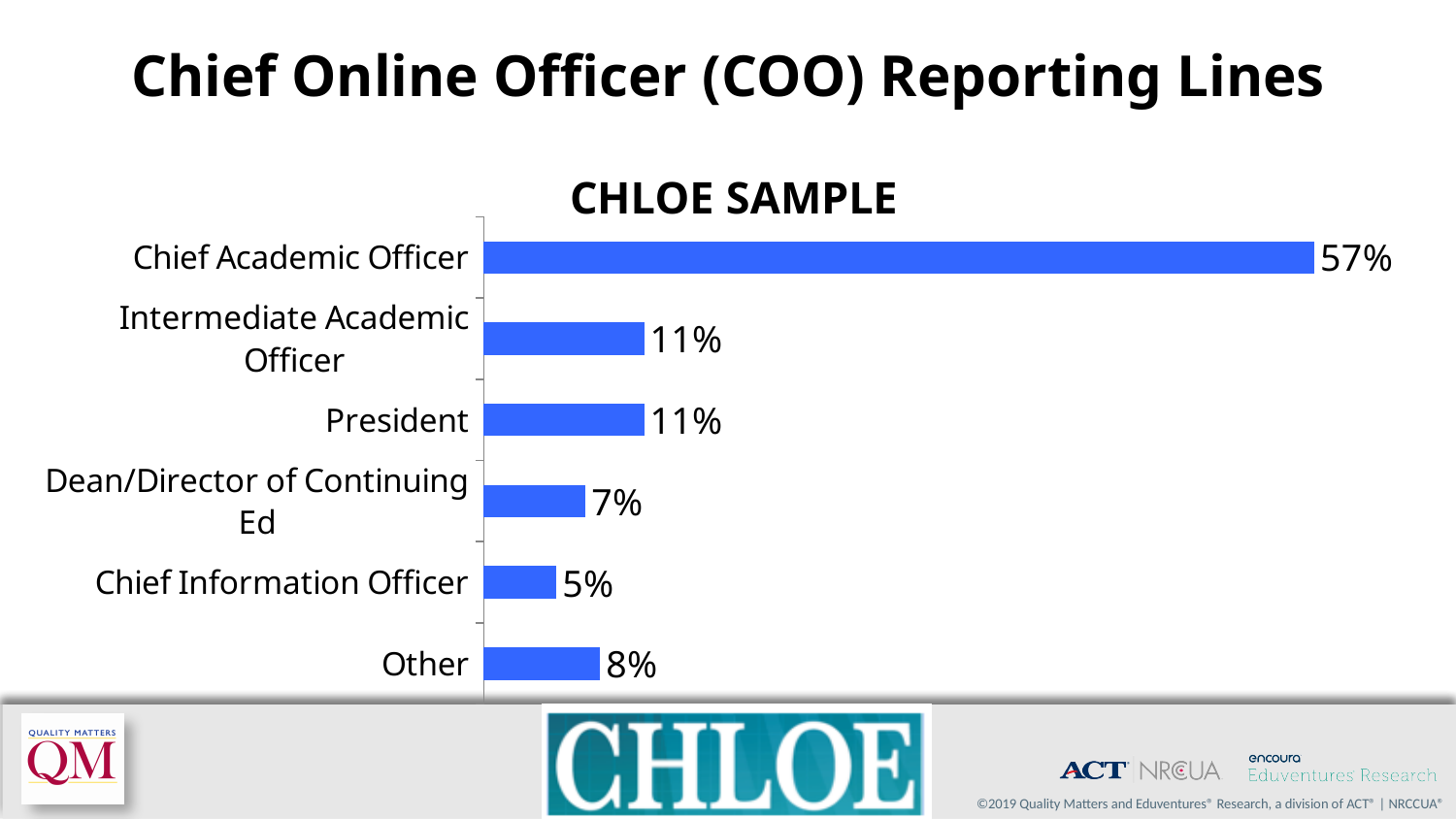
Which reporting line has the lowest percentage? Chief Information Officer What is the value for Other? 8% What type of chart is shown on the slide? Bar chart What is the difference between the Other value and the Chief Information Officer value? 3% What is the value for Chief Information Officer? 5% How many reporting line categories are shown in the chart? 6 Which is larger, the value for Other or the value for Dean/Director of Continuing Ed? Other What percentage of Chief Online Officers report to the Chief Academic Officer? 57% Which reporting line has the highest percentage? Chief Academic Officer What is the difference between the Chief Academic Officer value and the President value? 46% What is the value for Dean/Director of Continuing Ed? 7% What is the title of the chart? CHLOE SAMPLE